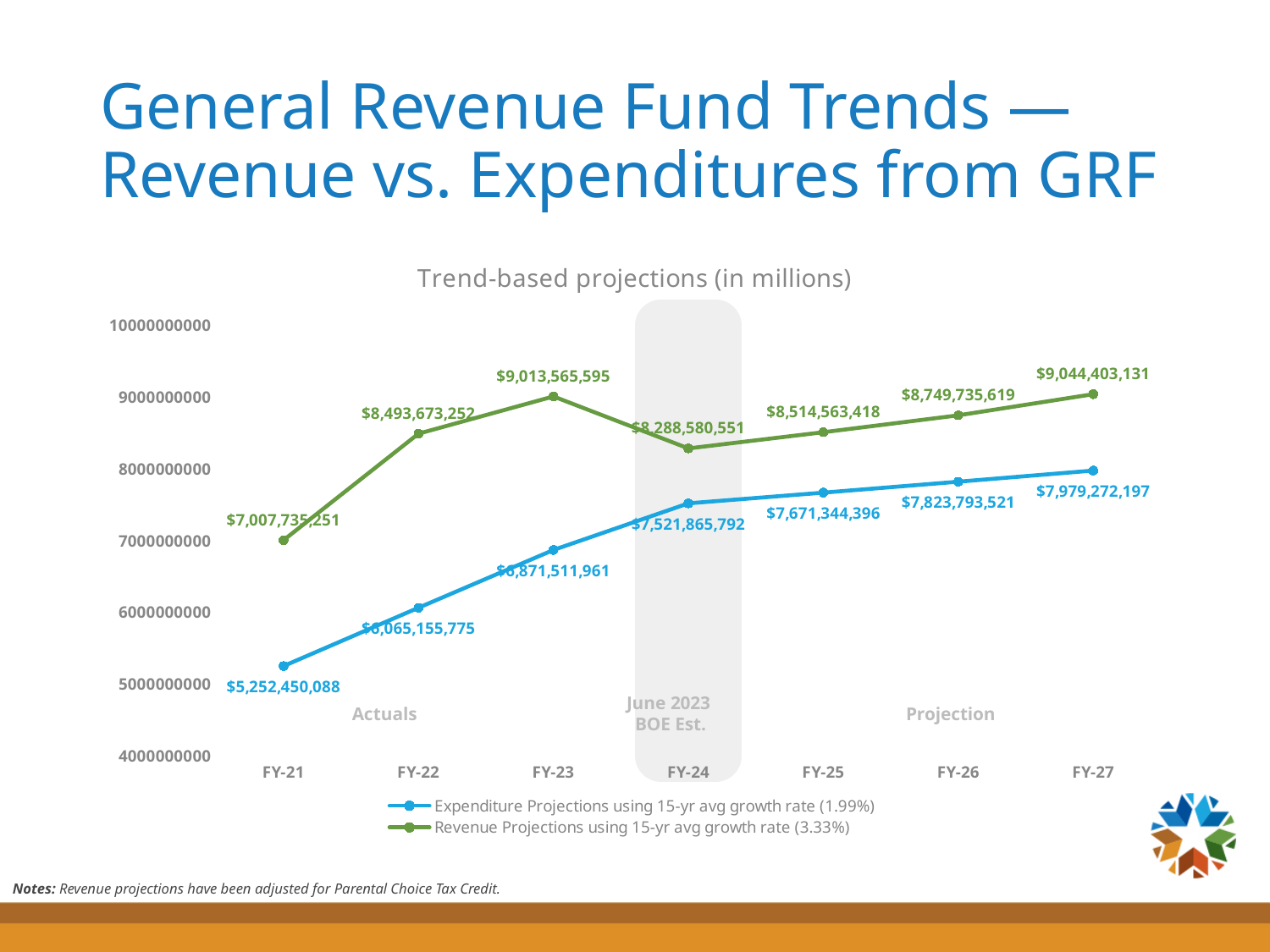
What is the difference between revenue and expenditure in FY-27? $1,065,130,934 What kind of chart is shown on the slide? Line chart Which is larger in FY-23, revenue or expenditure? Revenue How many series does the legend list? 2 What is the revenue value for FY-26? $8,749,735,619 What is the revenue projection value for FY-27? $9,044,403,131 Is the expenditure value for FY-21 greater or less than 6000000000? less In which fiscal year is the expenditure value lowest? FY-21 What is the expenditure value for FY-21? $5,252,450,088 In which fiscal year is the revenue projection highest? FY-27 What is the expenditure projection value for FY-25? $7,671,344,396 How many fiscal years are plotted on the x axis? 7